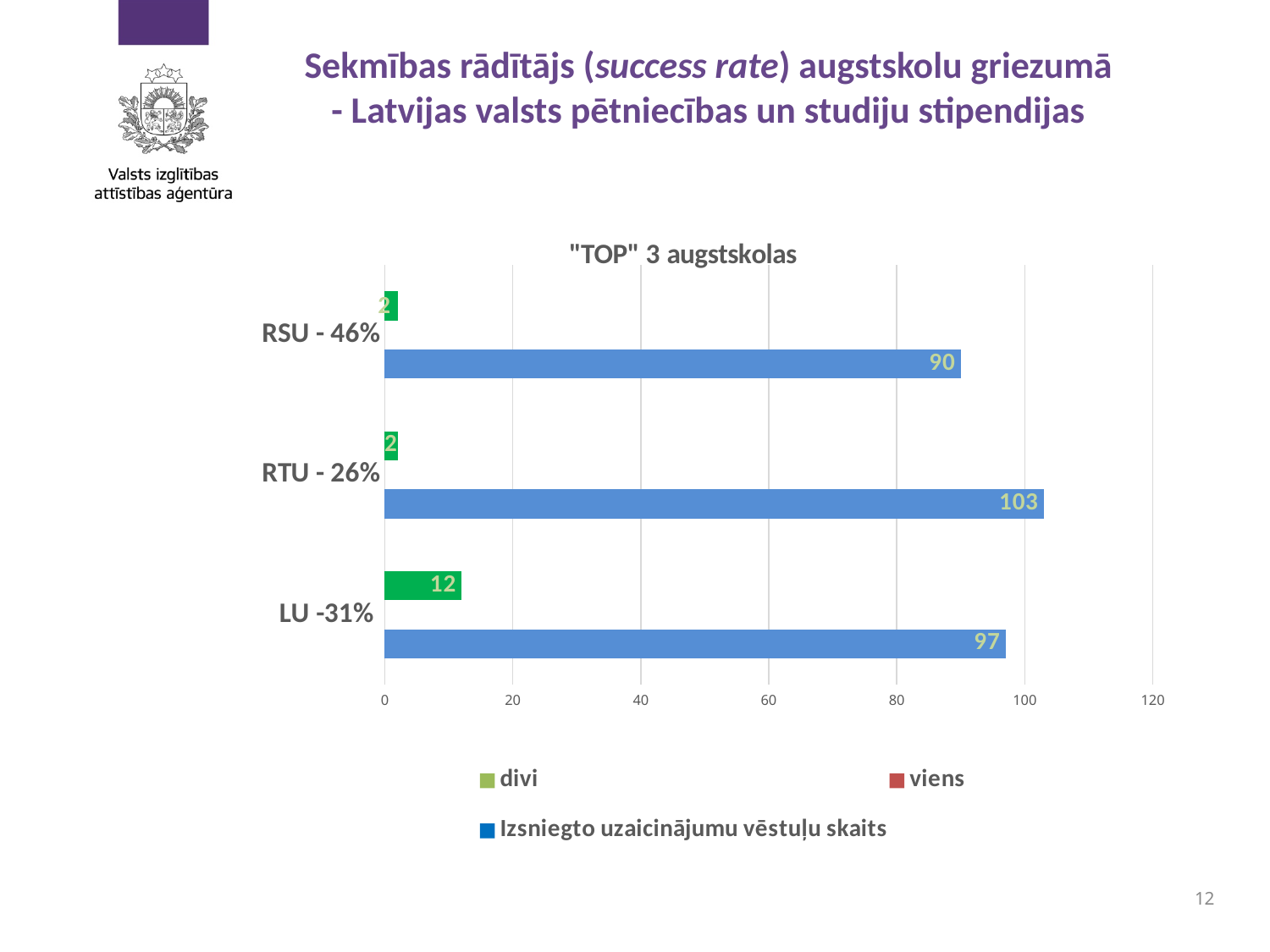
What is the value of the green bar for LU -31%? 12 What type of chart is shown on the slide? Bar chart How many categories are shown on the vertical axis of the chart? 3 What is the value of the blue 'Izsniegto uzaicinājumu vēstuļu skaits' bar for RSU - 46%? 90 Which category has the highest value in the blue 'Izsniegto uzaicinājumu vēstuļu skaits' series? RTU - 26% Is the blue bar value for RTU - 26% greater or less than 100? greater What is the difference between the blue bar values for RTU - 26% and RSU - 46%? 13 Which is larger: the blue bar for LU -31% or the blue bar for RSU - 46%? LU -31% Which category has the lowest value in the blue 'Izsniegto uzaicinājumu vēstuļu skaits' series? RSU - 46% What is the value of the blue 'Izsniegto uzaicinājumu vēstuļu skaits' bar for RTU - 26%? 103 How many series does the chart legend list? 3 What is the value of the blue 'Izsniegto uzaicinājumu vēstuļu skaits' bar for LU -31%? 97